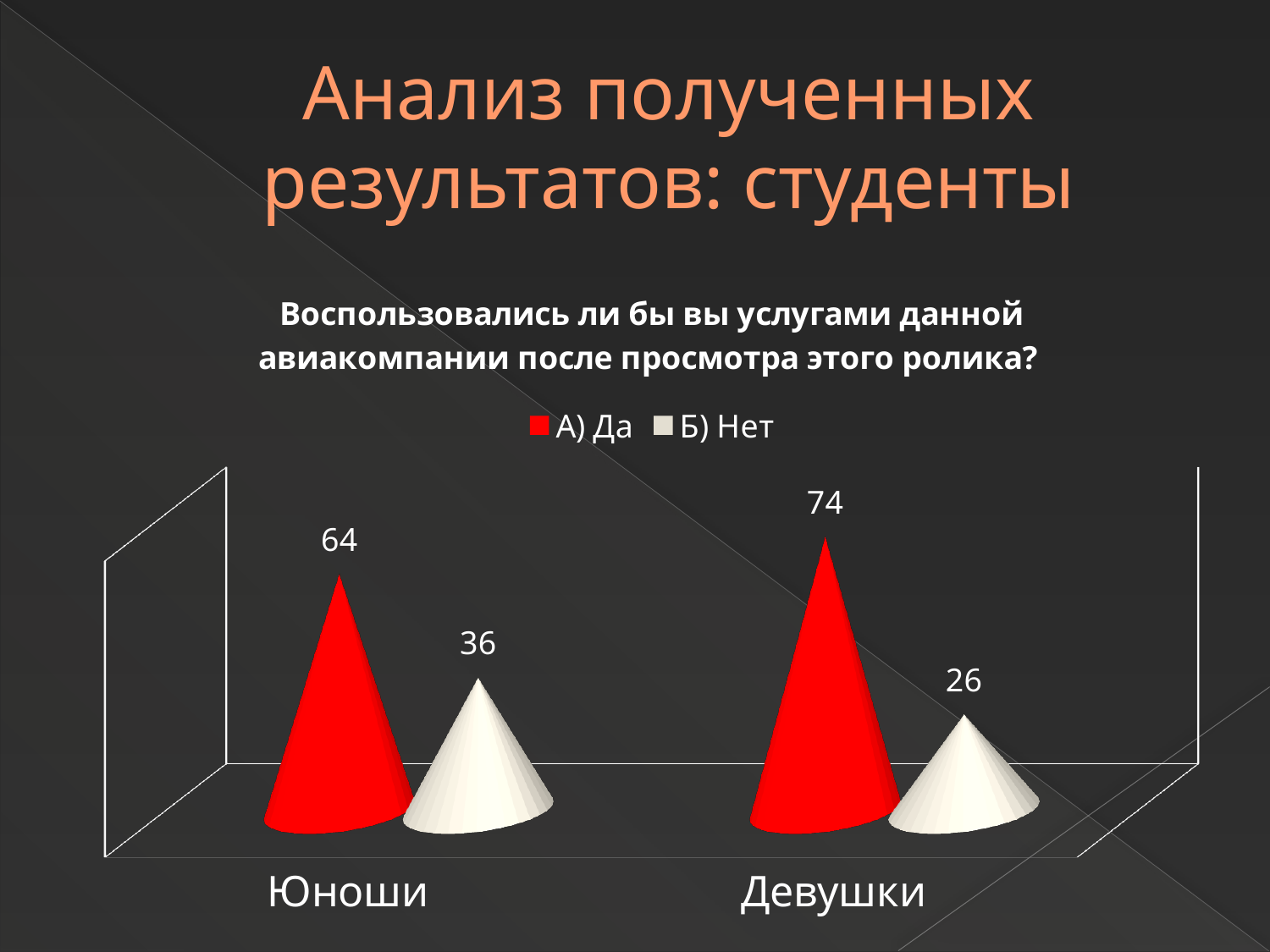
What is the value for 'Б) Нет' in the 'Юноши' category? 36 What is the value for 'Б) Нет' in the 'Девушки' category? 26 Which is larger: 'А) Да' for 'Юноши' or 'Б) Нет' for 'Юноши'? А) Да for Юноши Which category has the lowest value for 'Б) Нет'? Девушки What is the title of the chart? Воспользовались ли бы вы услугами данной авиакомпании после просмотра этого ролика? What is the value for 'А) Да' in the 'Юноши' category? 64 How many series does the legend list? 2 What is the difference between the 'А) Да' values for 'Девушки' and 'Юноши'? 10 Which colour represents the 'А) Да' series? Red What kind of chart is shown on the slide? Bar chart Which category has the highest value for 'А) Да'? Девушки How many categories are shown on the x axis? 2